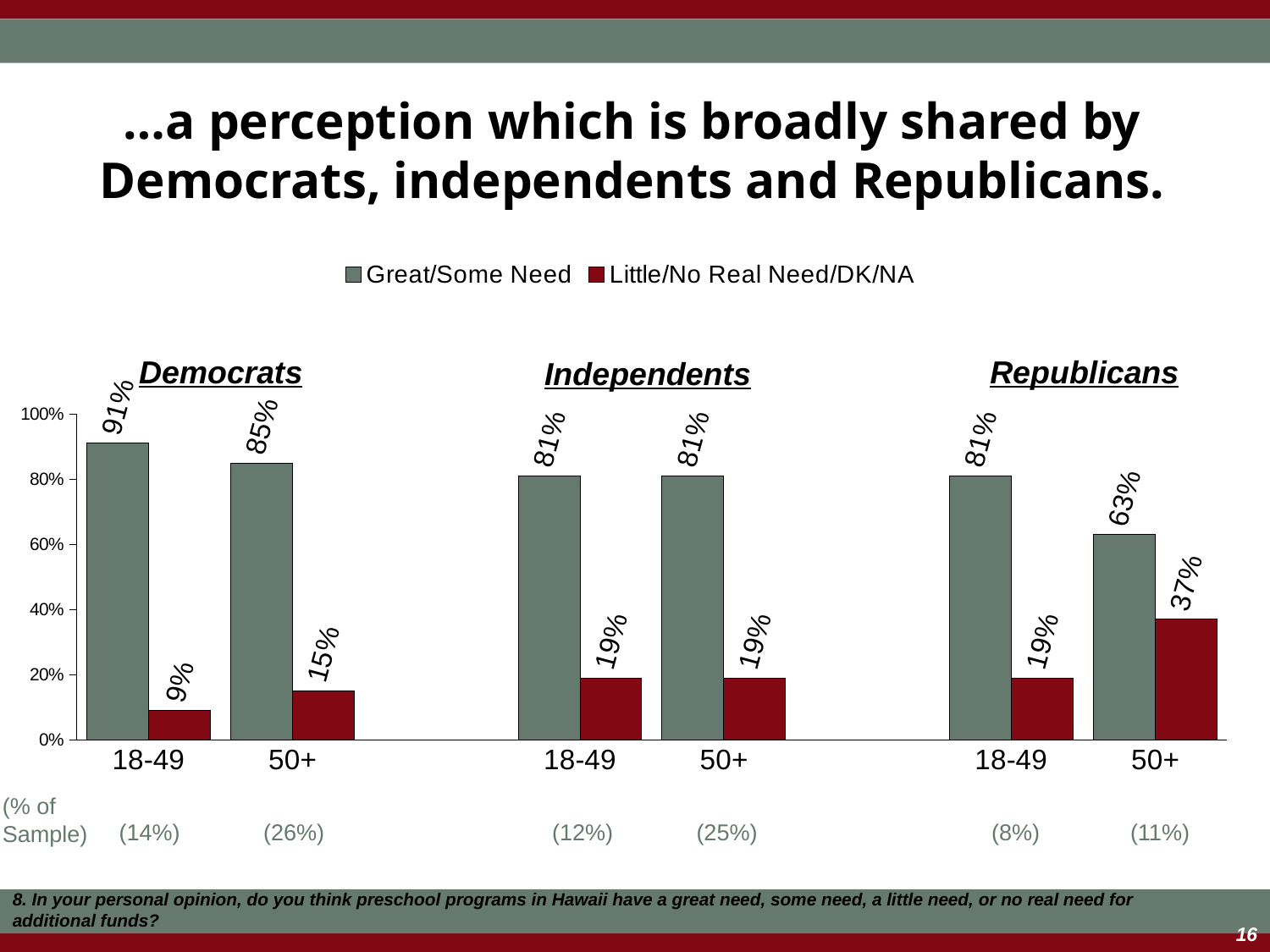
Which group and age category has the highest Great/Some Need value? Democrats 18-49 What is the Great/Some Need value for Independents aged 50+? 81% What percentage of Republicans aged 50+ say there is Little/No Real Need/DK/NA? 37% Which group and age category has the lowest Great/Some Need value? Republicans 50+ What is the difference between the Great/Some Need values for Republicans aged 18-49 and Republicans aged 50+? 18% Within the Republicans group, does the Great/Some Need value rise or fall from 18-49 to 50+? Fall What kind of chart is shown on the slide? Bar chart What is the difference between the Little/No Real Need/DK/NA values for Democrats aged 18-49 and Democrats aged 50+? 6% Which is larger: the Little/No Real Need/DK/NA value for Democrats aged 50+ or for Independents aged 50+? Independents 50+ How many series does the legend list? 2 Which colour represents the Little/No Real Need/DK/NA series? Dark red What percentage of Democrats aged 18-49 say there is Great/Some Need? 91%